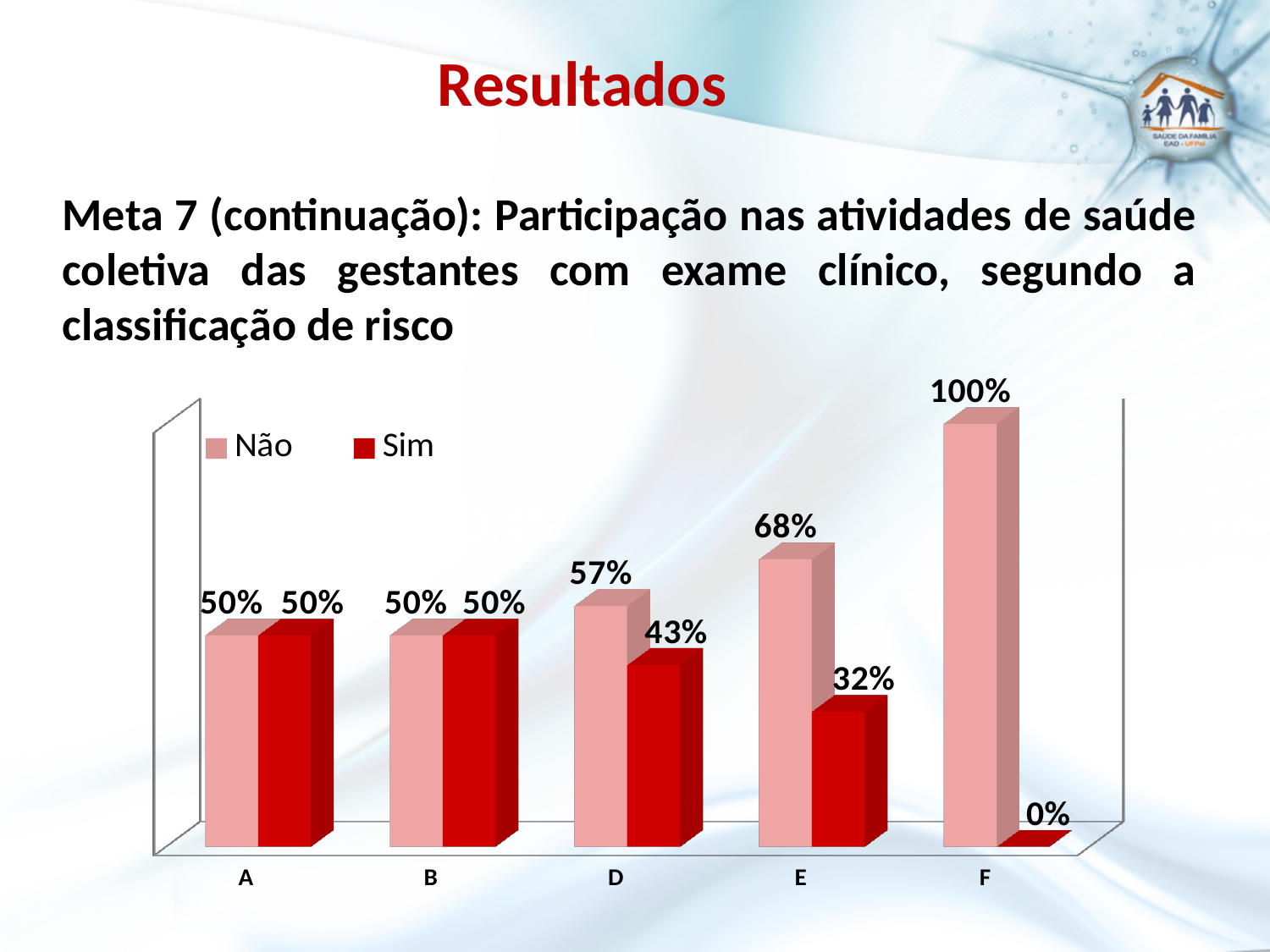
How many series does the legend list? 2 What are the two series names listed in the legend? Não and Sim What kind of chart is shown on the slide? Bar chart What is the value of the Sim series for category E? 32% Which category has the lowest Sim value? F What is the value of the Sim series for category D? 43% Which category has the highest Não value? F How many categories are shown on the x axis? 5 What is the difference between the Não and Sim values for category D? 14% What is the value of the Não series for category E? 68% What is the value of the Não series for category F? 100% For category E, which is larger, the Não value or the Sim value? Não